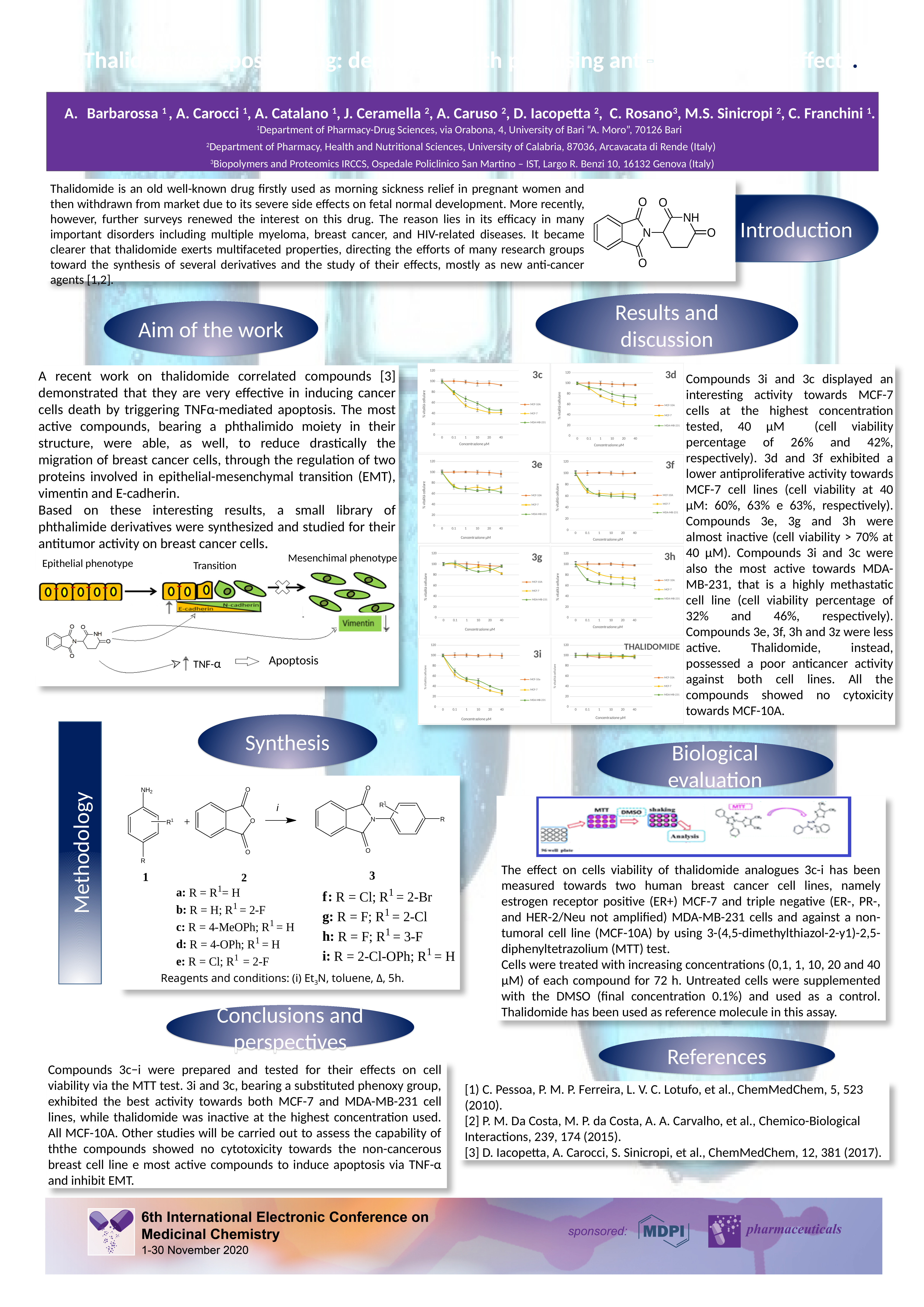
How many small line charts are shown in the Results and discussion section? 8 In the chart titled 3i, does the MCF-7 series rise or fall as concentration increases along the x axis? fall How many series does the legend of the chart titled 3i list? 3 In the chart titled 3h, which series has the highest value at 40 µM? MCF-10A How many concentration points are shown on the x axis of the chart titled 3d? 6 In the chart titled 3i, which series has the higher value at 40 µM, MCF-10A or MCF-7? MCF-10A What is the x-axis title of the chart titled 3g? Concentrazione µM What kind of chart is the chart titled 3c? line chart In the chart titled 3c, is the MCF-10A value at 40 µM greater or less than 80? greater In the chart titled THALIDOMIDE, is the MDA-MB-231 value at 40 µM greater or less than 80? greater In the chart titled 3e, is the MCF-7 value at 40 µM greater or less than 40? greater